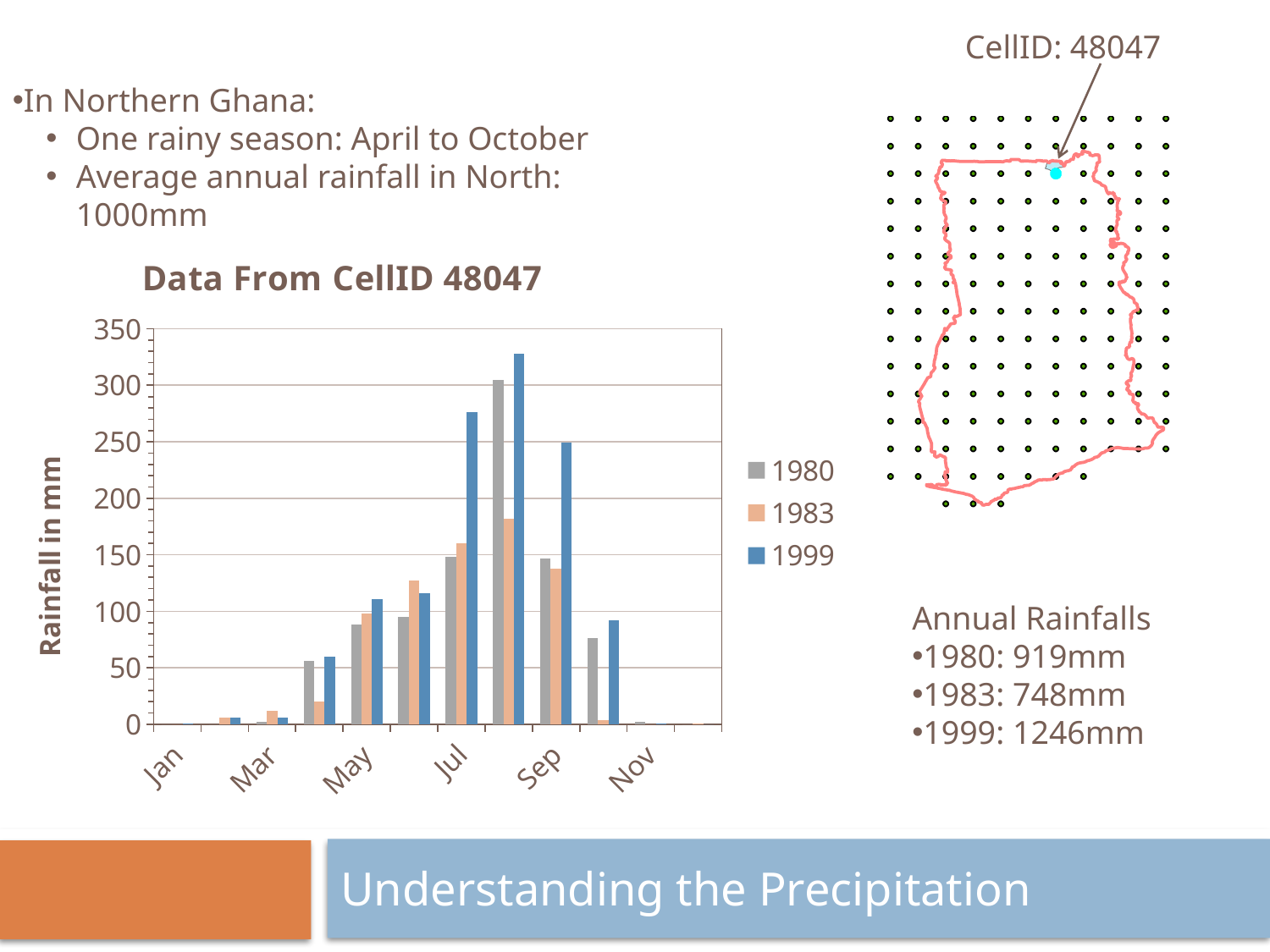
In Sep, which series has the larger value, 1983 or 1999? 1999 Do the values for 1999 rise or fall from May to Jul? rise Is the value for 1980 in Jul greater or less than 100? greater What is the title of the chart? Data From CellID 48047 Is the value for 1983 in Sep greater or less than 100? greater How many series does the chart legend list? 3 What is the label on the vertical axis of the chart? Rainfall in mm What kind of chart is shown on the slide? bar chart In Jul, which series has the larger value, 1980 or 1999? 1999 Is the value for 1980 in May greater or less than 100? less